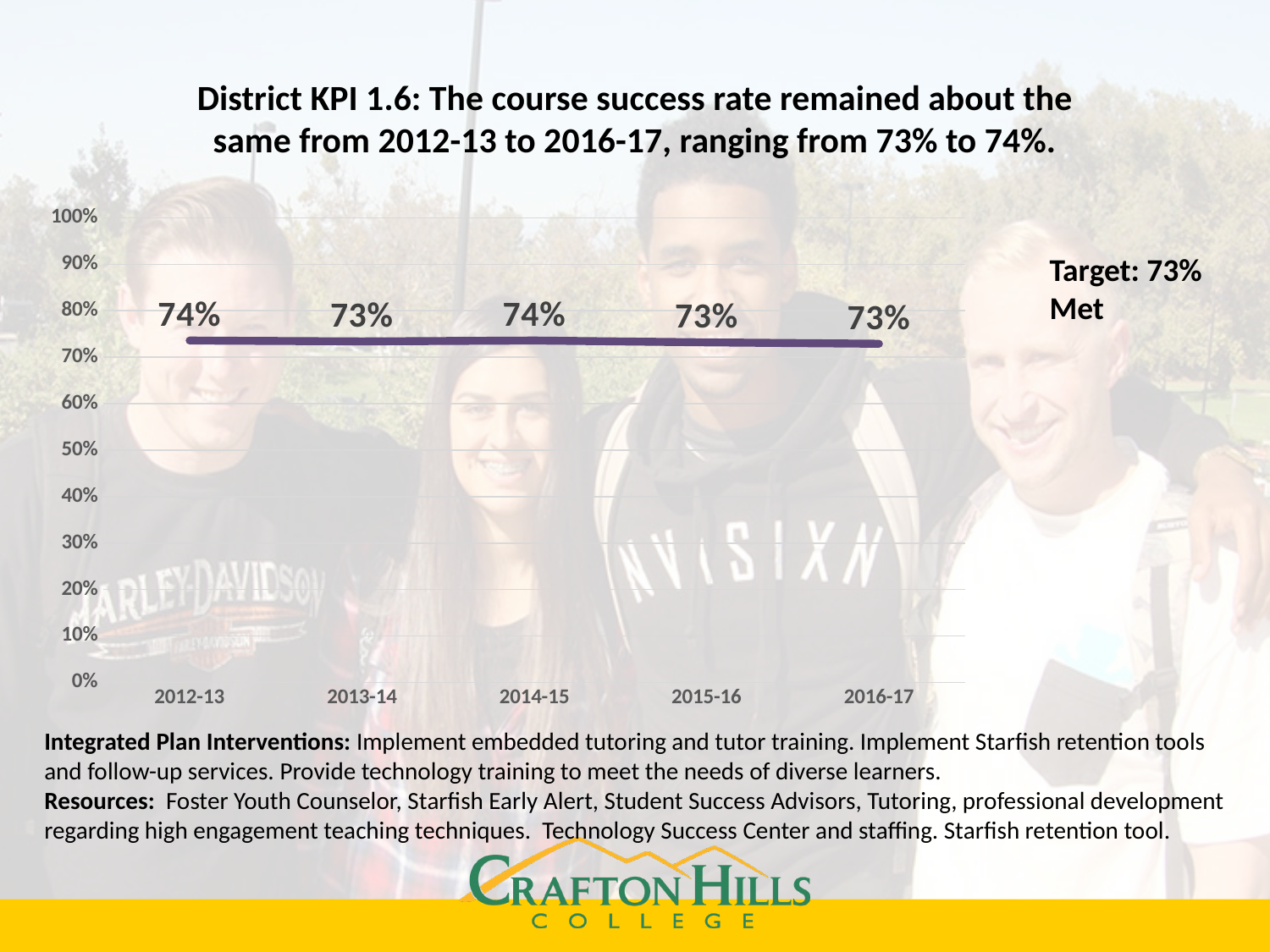
What is the course success rate for 2014-15? 74% What is the highest value shown on the y axis? 100% What is the course success rate for 2016-17? 73% How many academic years are plotted on the chart? 5 What is the difference between the course success rate in 2012-13 and 2013-14? 1% Is the course success rate for 2015-16 greater or less than 70%? greater What target value is stated on the slide? 73% Does the course success rate rise, fall, or stay about the same from 2012-13 to 2016-17? stays about the same What kind of chart is shown on the slide? line chart What is the course success rate for 2012-13? 74% Is the course success rate for 2014-15 greater or less than 80%? less What is the course success rate for 2013-14? 73%